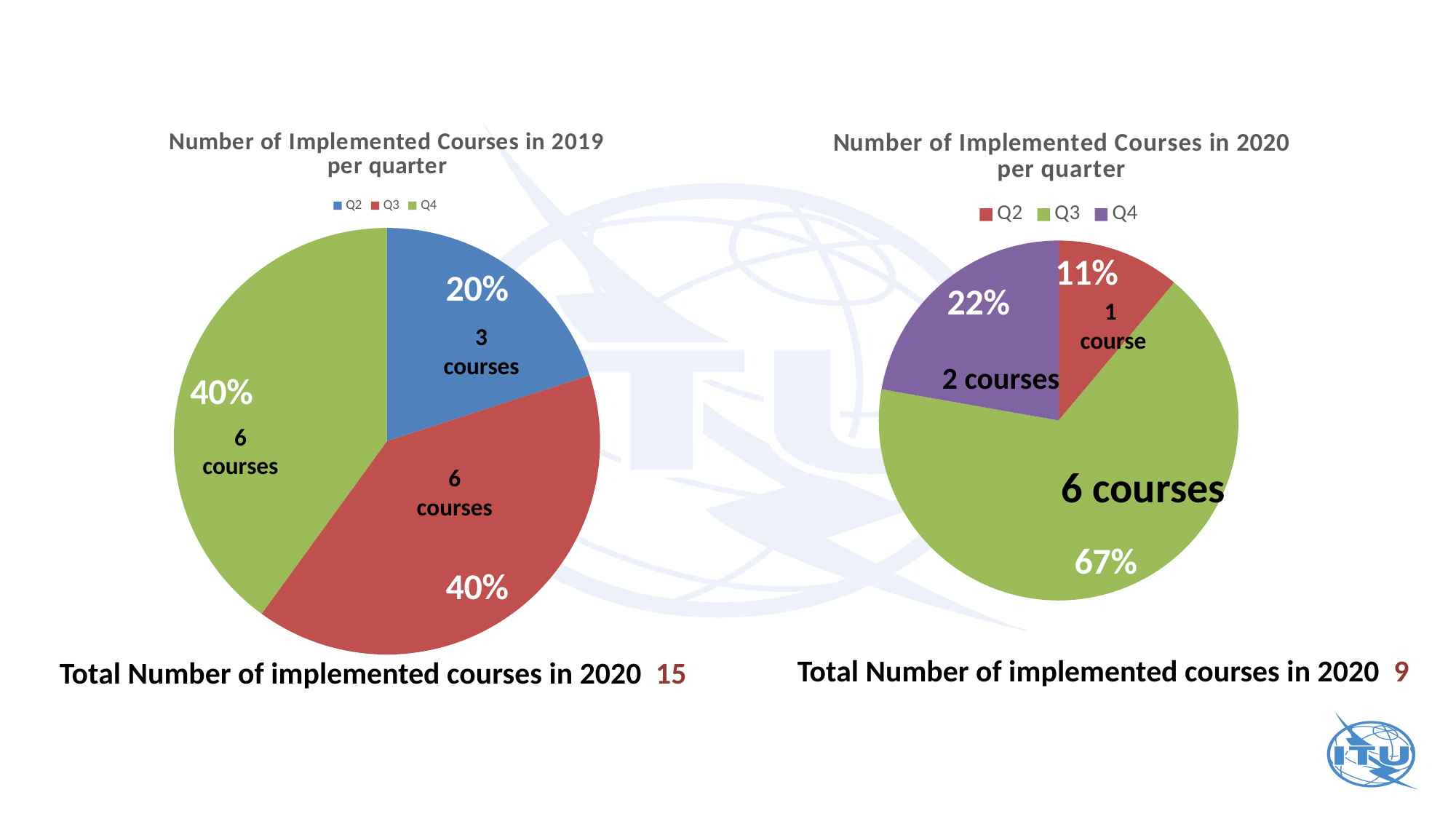
What type of chart is used on this slide? pie chart In the 'Number of Implemented Courses in 2019 per quarter' chart, which quarter has the smallest slice? Q2 In the 'Number of Implemented Courses in 2020 per quarter' chart, what is the difference in courses between Q3 and Q2? 5 How many quarters are shown in the 'Number of Implemented Courses in 2020 per quarter' chart? 3 In the 'Number of Implemented Courses in 2020 per quarter' chart, which quarter has the largest slice? Q3 In the 'Number of Implemented Courses in 2019 per quarter' chart, how many courses were implemented in Q2? 3 courses In the 'Number of Implemented Courses in 2020 per quarter' chart, what percentage share does Q4 have? 22% In the 'Number of Implemented Courses in 2019 per quarter' chart, what percentage share does Q3 have? 40% In the 'Number of Implemented Courses in 2019 per quarter' chart, what colour is the Q2 slice? blue In the 'Number of Implemented Courses in 2019 per quarter' chart, is the Q3 slice larger or smaller than the Q2 slice? larger In the 'Number of Implemented Courses in 2020 per quarter' chart, which quarter has the smallest slice? Q2 In the 'Number of Implemented Courses in 2020 per quarter' chart, how many courses were implemented in Q3? 6 courses